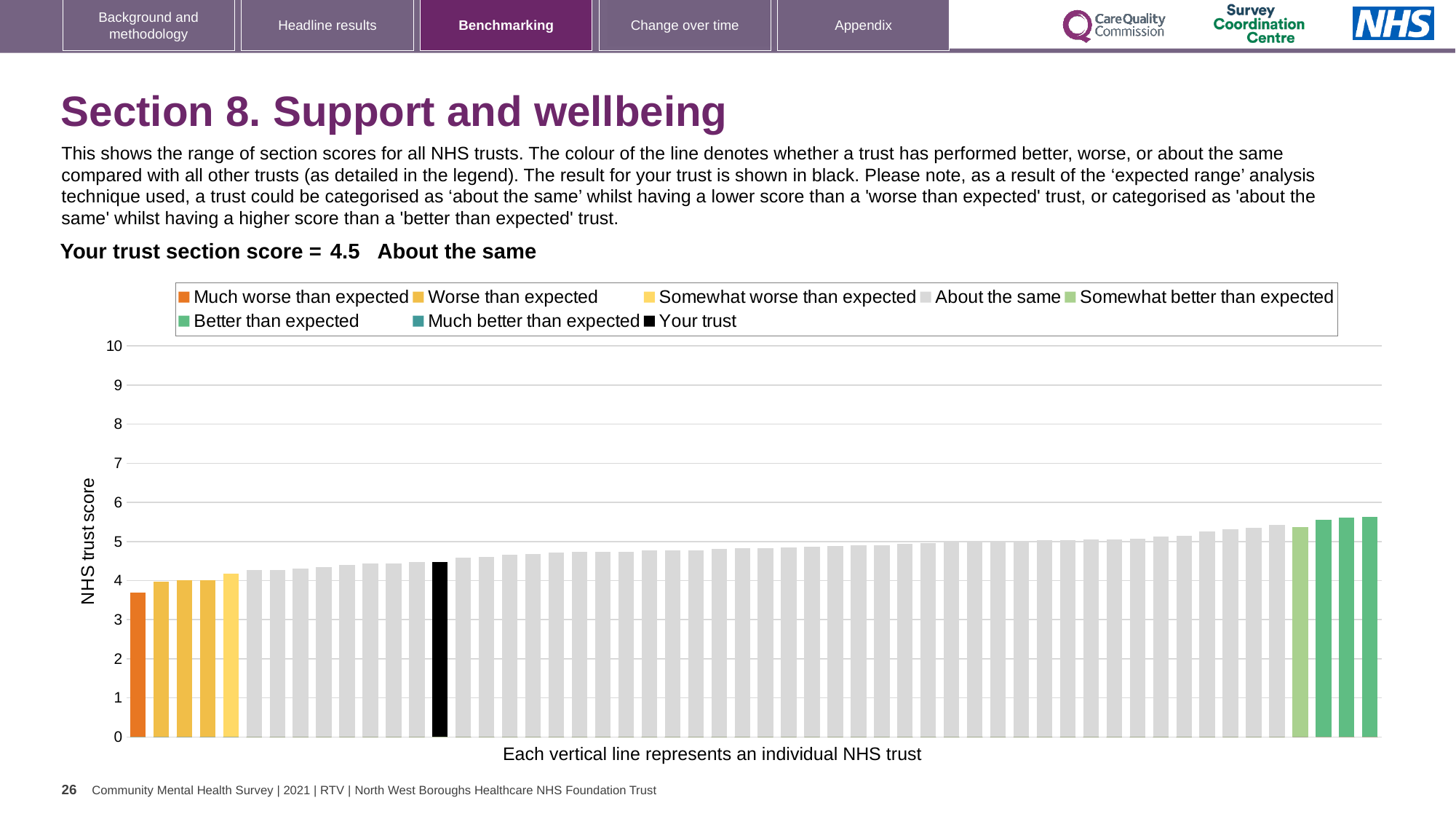
What colour is the bar representing your trust? black How many bars are coloured orange ('Much worse than expected')? 1 Which category is your trust's section score placed in? About the same What kind of chart is shown on the slide? bar chart Is the value of the black 'Your trust' bar greater or less than 5? less How many bars are coloured green ('Better than expected')? 3 Is the value of the rightmost bar greater or less than 6? less What is the section score for your trust shown on the slide? 4.5 Do the bar values rise or fall from left to right along the x axis? rise Is the value of the leftmost (orange) bar greater or less than 4? less What is the label on the vertical axis of the chart? NHS trust score How many entries does the chart legend list? 8